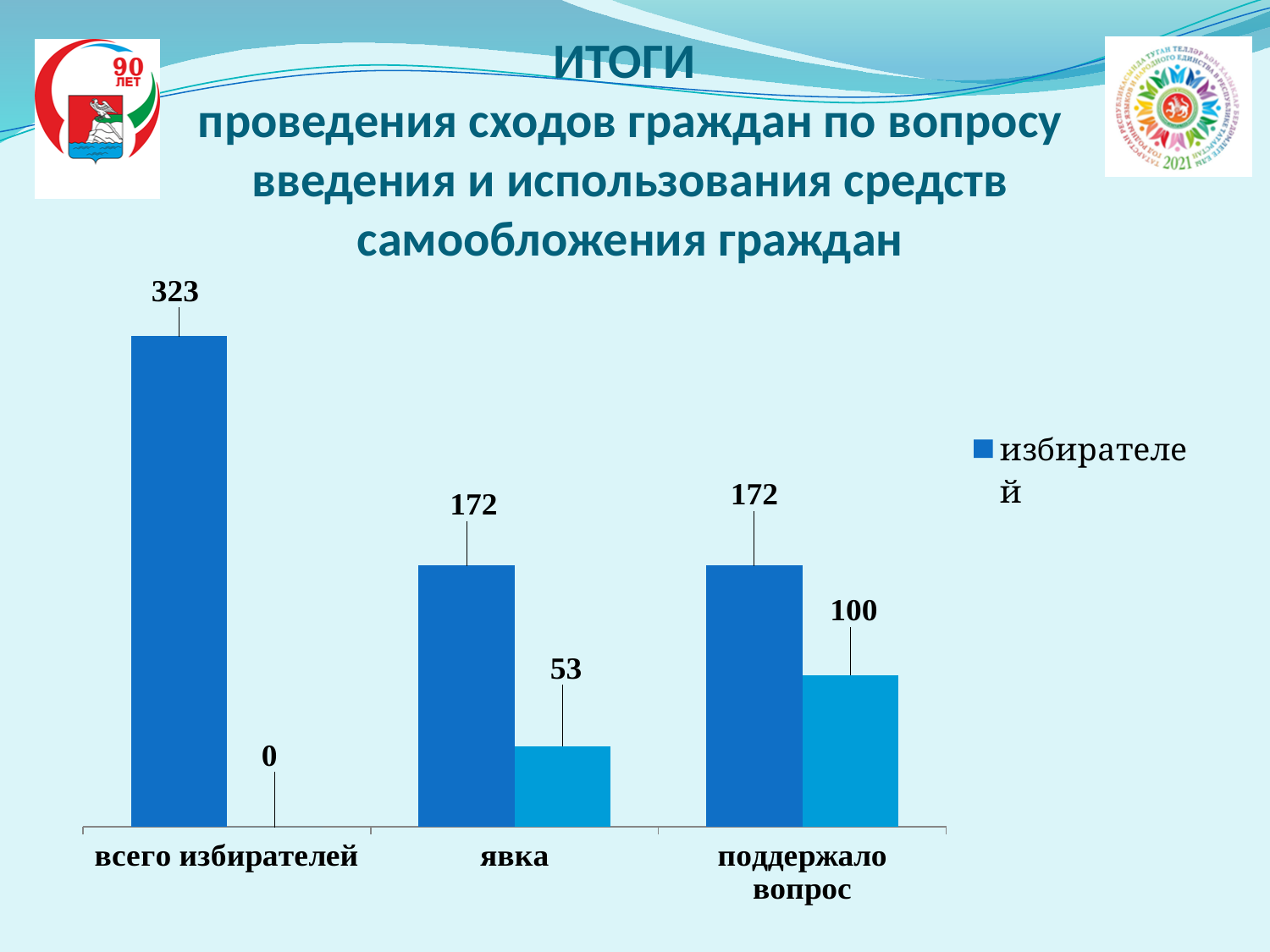
For "поддержало вопрос", which bar is larger, the dark blue or the light blue? dark blue What is the difference between the light blue values for "поддержало вопрос" and "явка"? 47 Which category has the lowest light blue value? всего избирателей How many categories are shown on the x axis? 3 What is the value of the light blue bar for "всего избирателей"? 0 What is the difference between the dark blue values for "всего избирателей" and "явка"? 151 What is the value of the dark blue bar for "всего избирателей"? 323 What is the value of the dark blue bar for "явка"? 172 What kind of chart is shown on the slide? bar chart What is the value of the light blue bar for "поддержало вопрос"? 100 Which category has the highest dark blue bar? всего избирателей What is the value of the light blue bar for "явка"? 53